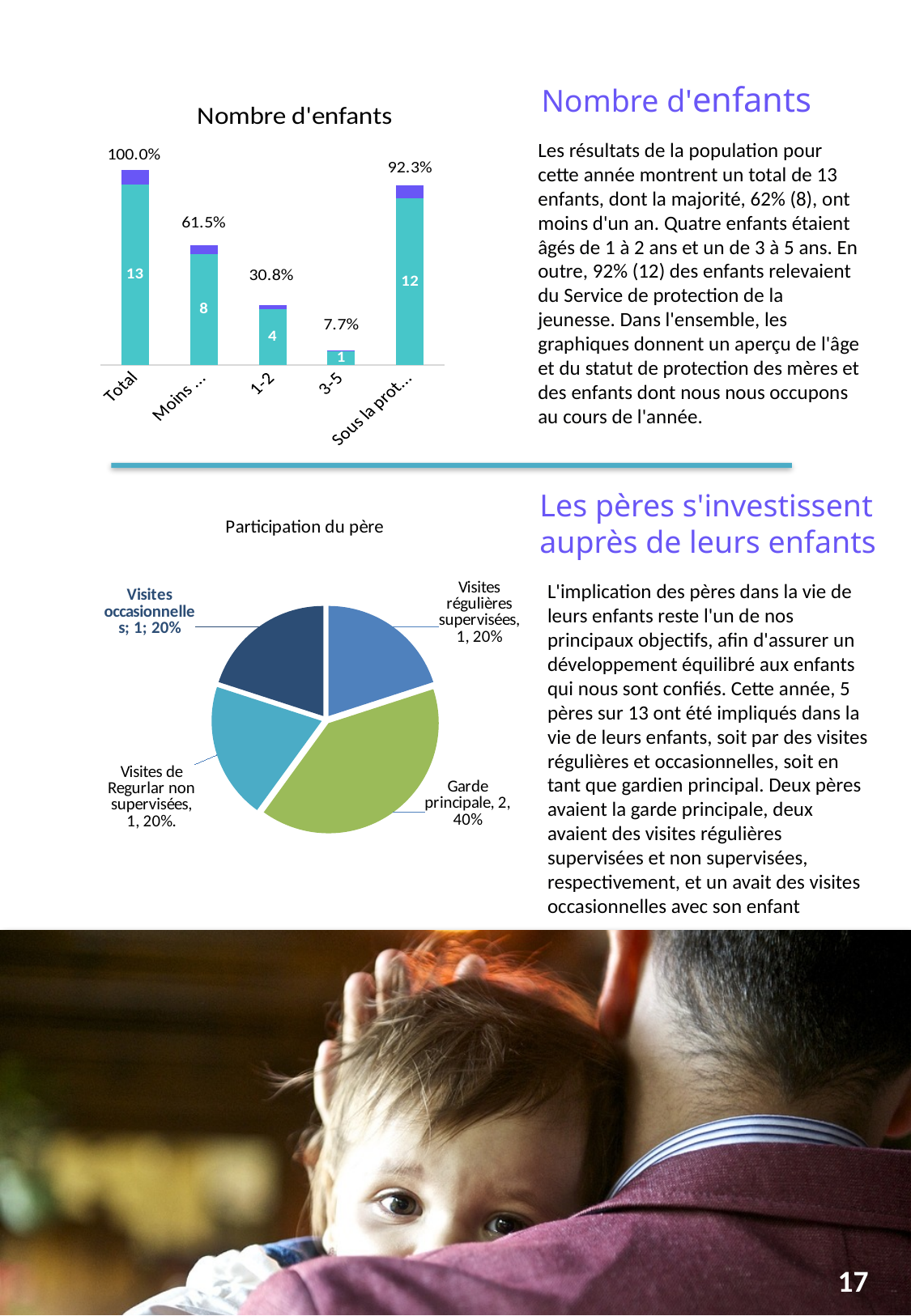
In the 'Nombre d'enfants' chart, what is the difference between the 'Total' value and the '1-2' value? 9 How many categories are shown on the x axis of the 'Nombre d'enfants' chart? 5 In the 'Nombre d'enfants' chart, which is larger, the value for '1-2' or the value for '3-5'? 1-2 What is the title of the bar chart at the top of the slide? Nombre d'enfants What kind of chart is the 'Nombre d'enfants' chart at the top of the slide? bar chart In the 'Participation du père' pie chart, what share does 'Garde principale' represent? 40% In the 'Nombre d'enfants' chart, which category has the lowest value? 3-5 In the 'Participation du père' pie chart, which slice is the largest? Garde principale What kind of chart is the 'Participation du père' chart? pie chart In the 'Nombre d'enfants' chart, what is the number of children shown for the '1-2' category? 4 In the 'Nombre d'enfants' chart, what percentage is shown above the '3-5' bar? 7.7% How many slices does the 'Participation du père' pie chart have? 4